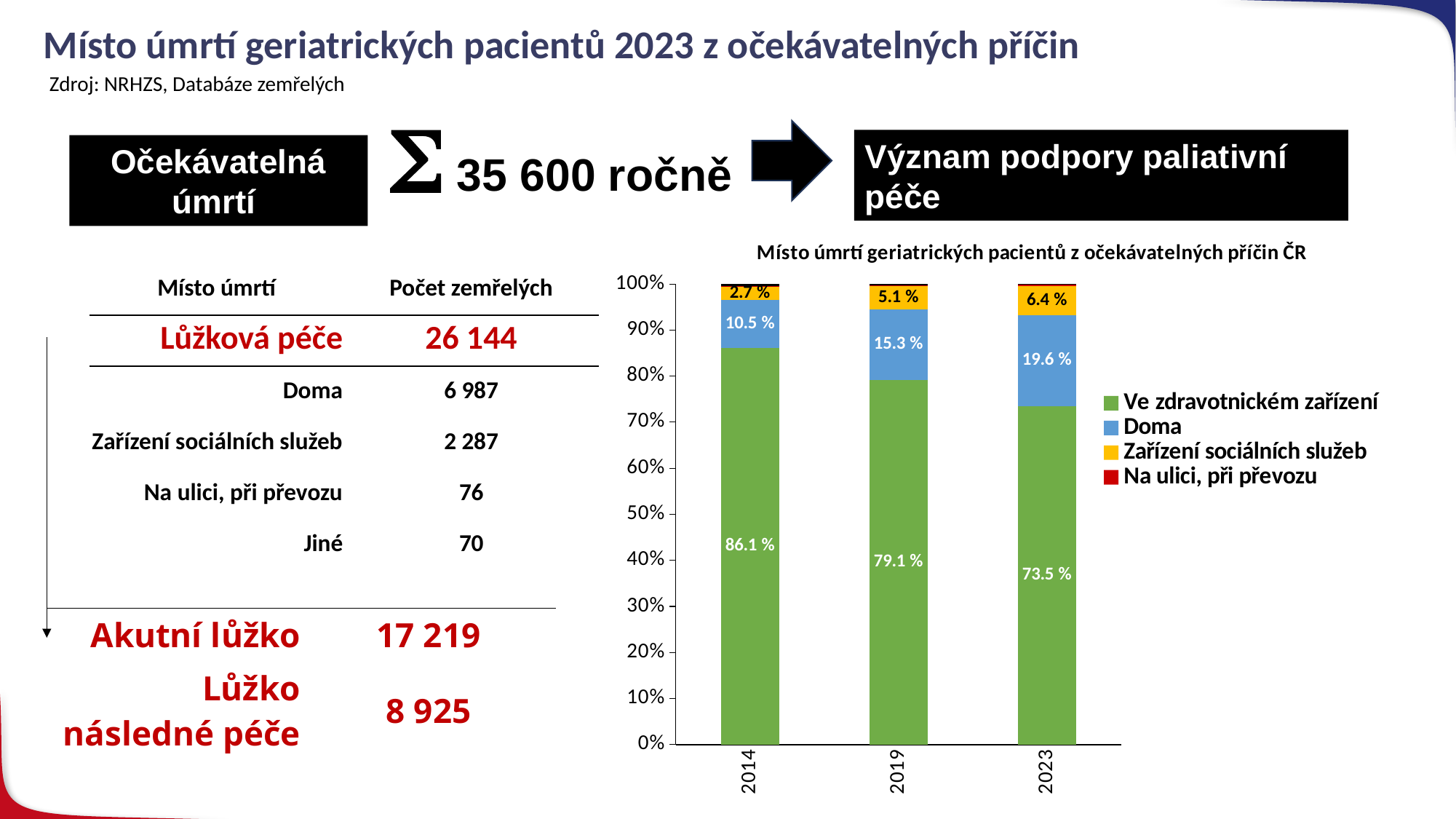
Is the value for Ve zdravotnickém zařízení in 2019 greater or less than 70%? greater What is the difference between the Ve zdravotnickém zařízení share in 2014 and in 2023? 12.6 % In which year was the share for Ve zdravotnickém zařízení the lowest? 2023 Does the share for Ve zdravotnickém zařízení rise or fall from 2014 to 2023? Fall How many years are shown on the x axis of the chart? 3 What is the value for Zařízení sociálních služeb in 2019? 5.1 % In which year was the share for Doma the highest? 2023 What kind of chart is shown on the slide? Stacked bar chart How many series does the chart legend list? 4 What is the value for Doma in 2023? 19.6 % Which is larger: the Doma share in 2019 or the Doma share in 2014? 2019 What percentage of geriatric patients died in a healthcare facility (Ve zdravotnickém zařízení) in 2014? 86.1 %